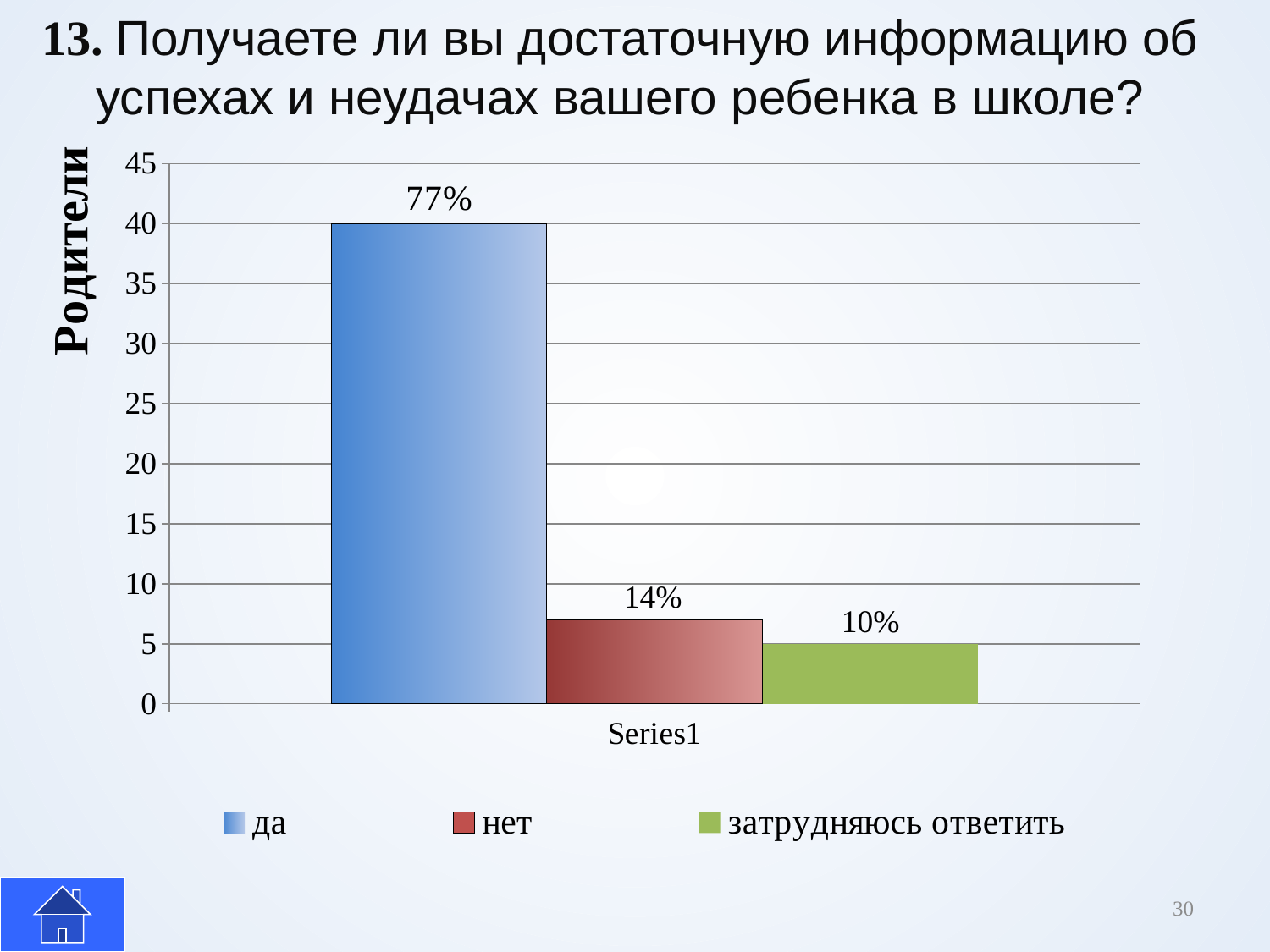
What is the data label on the bar for "да"? 77% What kind of chart is shown on the slide? bar chart What is the difference between the data labels for "да" and "нет"? 63% How many bars are plotted on the chart? 3 Is the bar for "нет" greater or less than 10 on the vertical axis? less What is the data label on the bar for "нет"? 14% Which is larger, the value for "нет" or the value for "затрудняюсь ответить"? нет What is the title of the vertical axis? Родители Which legend entry has the tallest bar? да Which legend entry has the shortest bar? затрудняюсь ответить What is the data label on the bar for "затрудняюсь ответить"? 10% How many entries does the legend list? 3